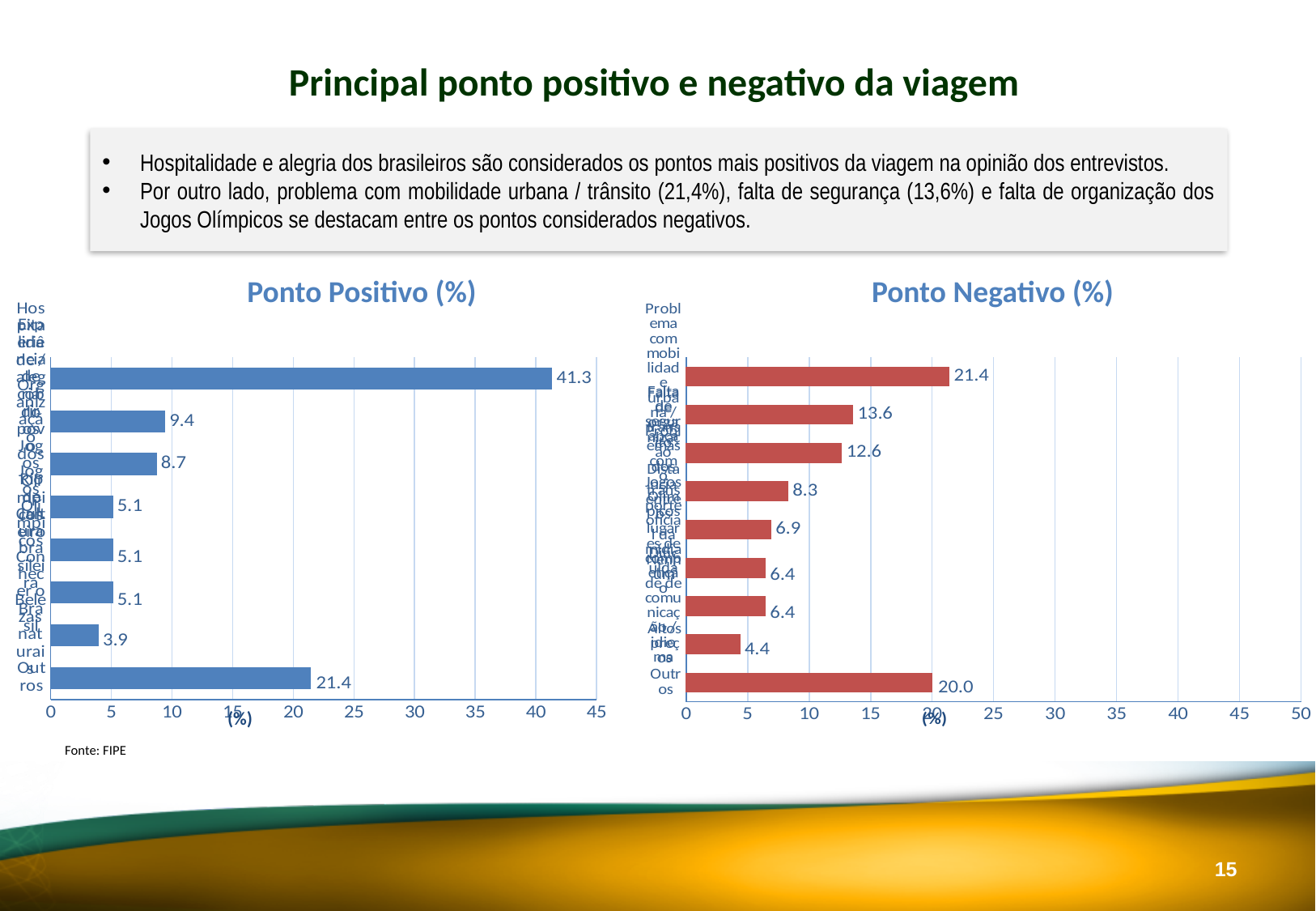
Which chart has the larger value for "Outros": "Ponto Positivo (%)" or "Ponto Negativo (%)"? Ponto Positivo (%) In the "Ponto Positivo (%)" chart, what is the value for "Outros"? 21.4 In the "Ponto Negativo (%)" chart, what is the lowest value shown? 4.4 What colour are the bars in the "Ponto Negativo (%)" chart? red What kind of chart is the "Ponto Positivo (%)" chart? bar chart In the "Ponto Positivo (%)" chart, what is the highest value shown? 41.3 How many bars are plotted in the "Ponto Positivo (%)" chart? 8 In the "Ponto Negativo (%)" chart, what is the highest value shown? 21.4 In the "Ponto Positivo (%)" chart, what is the lowest value shown? 3.9 In the "Ponto Negativo (%)" chart, what is the value for "Outros"? 20.0 How many bars are plotted in the "Ponto Negativo (%)" chart? 9 In the "Ponto Negativo (%)" chart, what is the difference between the top bar (21.4) and "Outros" (20.0)? 1.4